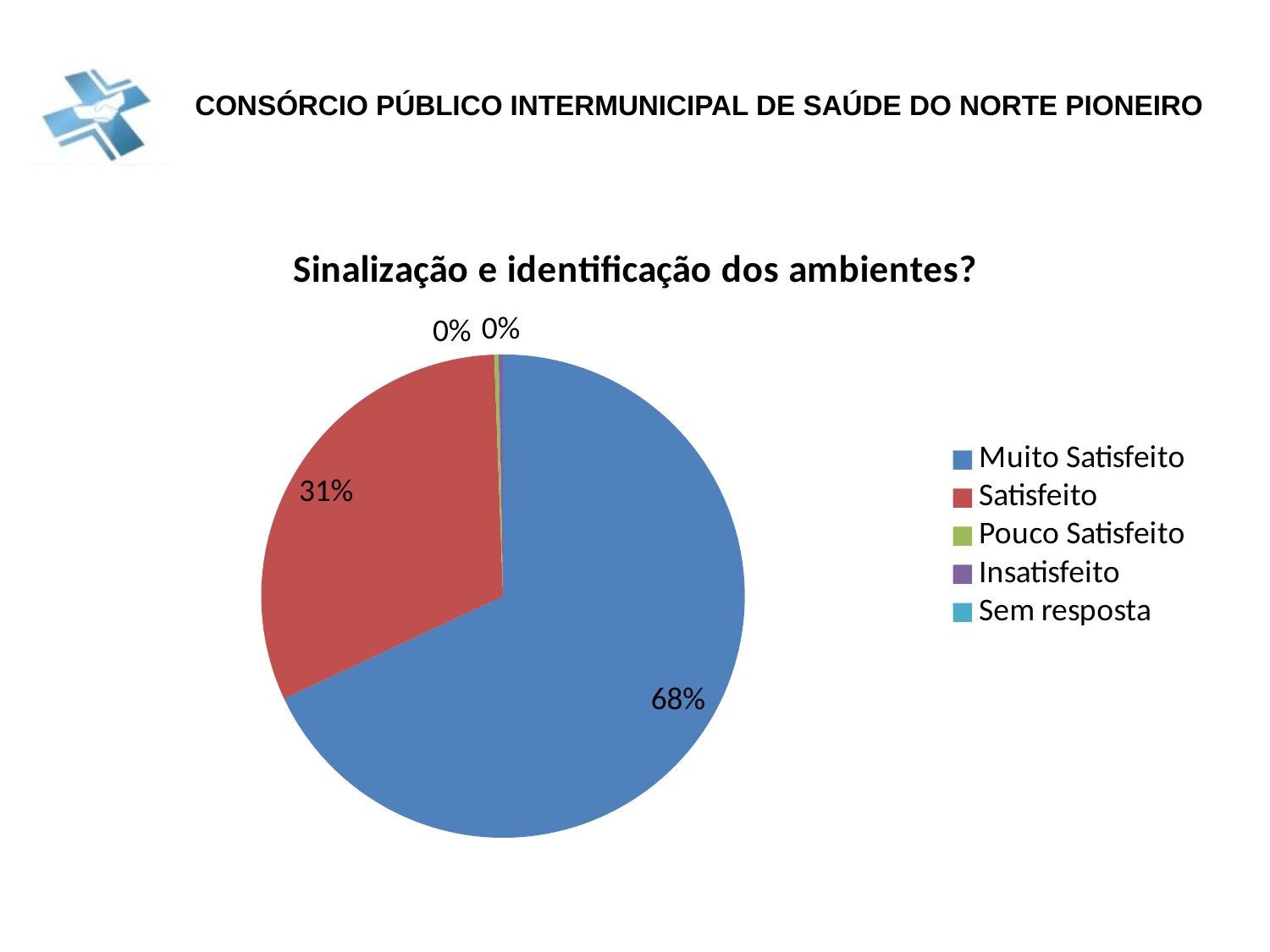
What kind of chart is shown on the slide? pie chart What is the difference in percentage points between the Muito Satisfeito slice and the Satisfeito slice? 37 How many slices are labelled 0% on the pie? 2 What share of the pie is labelled for Satisfeito? 31% What is the title of the pie chart? Sinalização e identificação dos ambientes? Which is larger, the slice for Muito Satisfeito or the slice for Satisfeito? Muito Satisfeito How many categories does the legend list? 5 Is the share for Muito Satisfeito greater or less than 50%? greater Which legend entry is shown in red? Satisfeito What share of the pie is labelled for Muito Satisfeito? 68% Which category has the largest slice of the pie? Muito Satisfeito